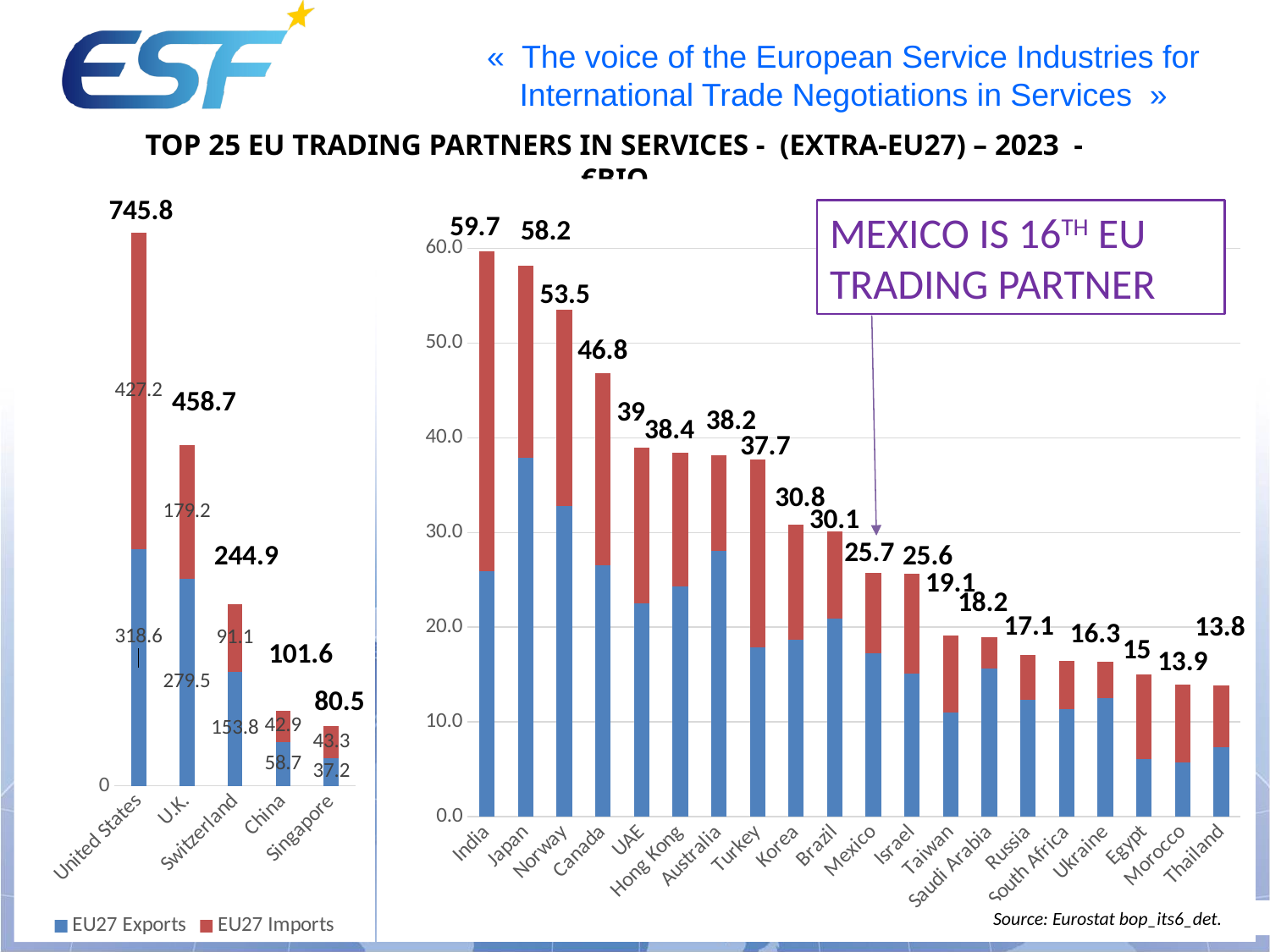
In the right chart, what is the total value shown for India? 59.7 In the right chart, is the total for Canada greater or less than 50.0? less In the left chart, which country has the lowest total? Singapore In the right chart, what is the difference between the totals for India and Japan? 1.5 In the left chart, how many countries are shown? 5 In the left chart, which country has the highest total? United States In the left chart, how many series does the legend list? 2 What kind of chart is the right chart? Stacked bar chart In the right chart, what is the total value shown for Mexico? 25.7 In the left chart, what is the total value shown for United States? 745.8 In the right chart, which country has the highest total? India In the left chart, what is the difference between the totals for U.K. and Switzerland? 213.8